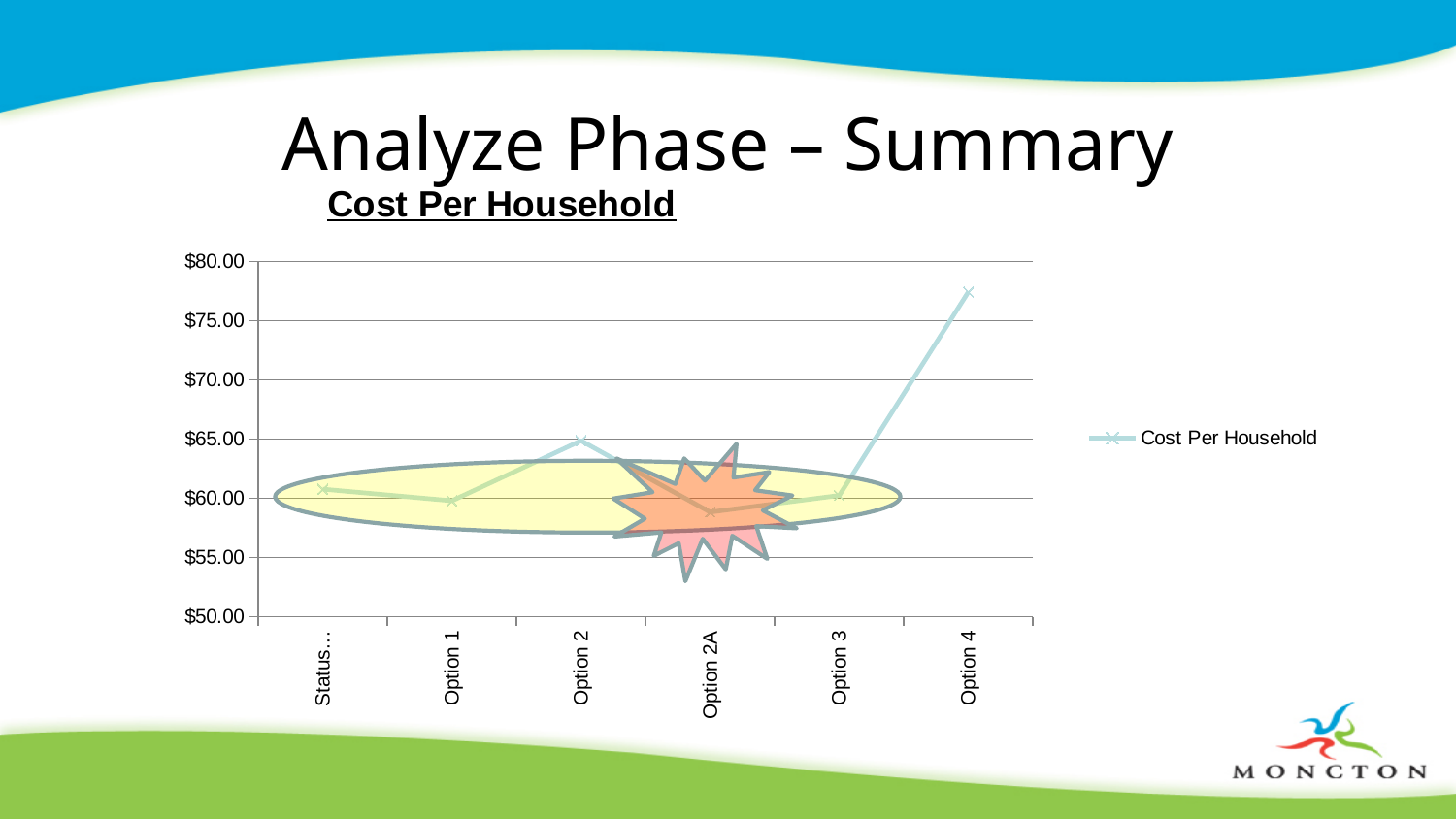
Does the cost per household rise or fall from Option 3 to Option 4? rise Which has a higher cost per household, Option 2 or Option 3? Option 2 Is the value for Option 2A greater or less than $60.00? less Is the value for Option 2 greater or less than $60.00? greater Is the value for Option 4 greater or less than $75.00? greater Which has a higher cost per household, Option 4 or Option 2? Option 4 Which category has the lowest cost per household? Option 2A What kind of chart is shown on the slide? line chart How many series does the chart's legend list? 1 Which category has the highest cost per household? Option 4 What is the name of the series shown in the legend? Cost Per Household How many categories are plotted along the x axis of the chart? 6